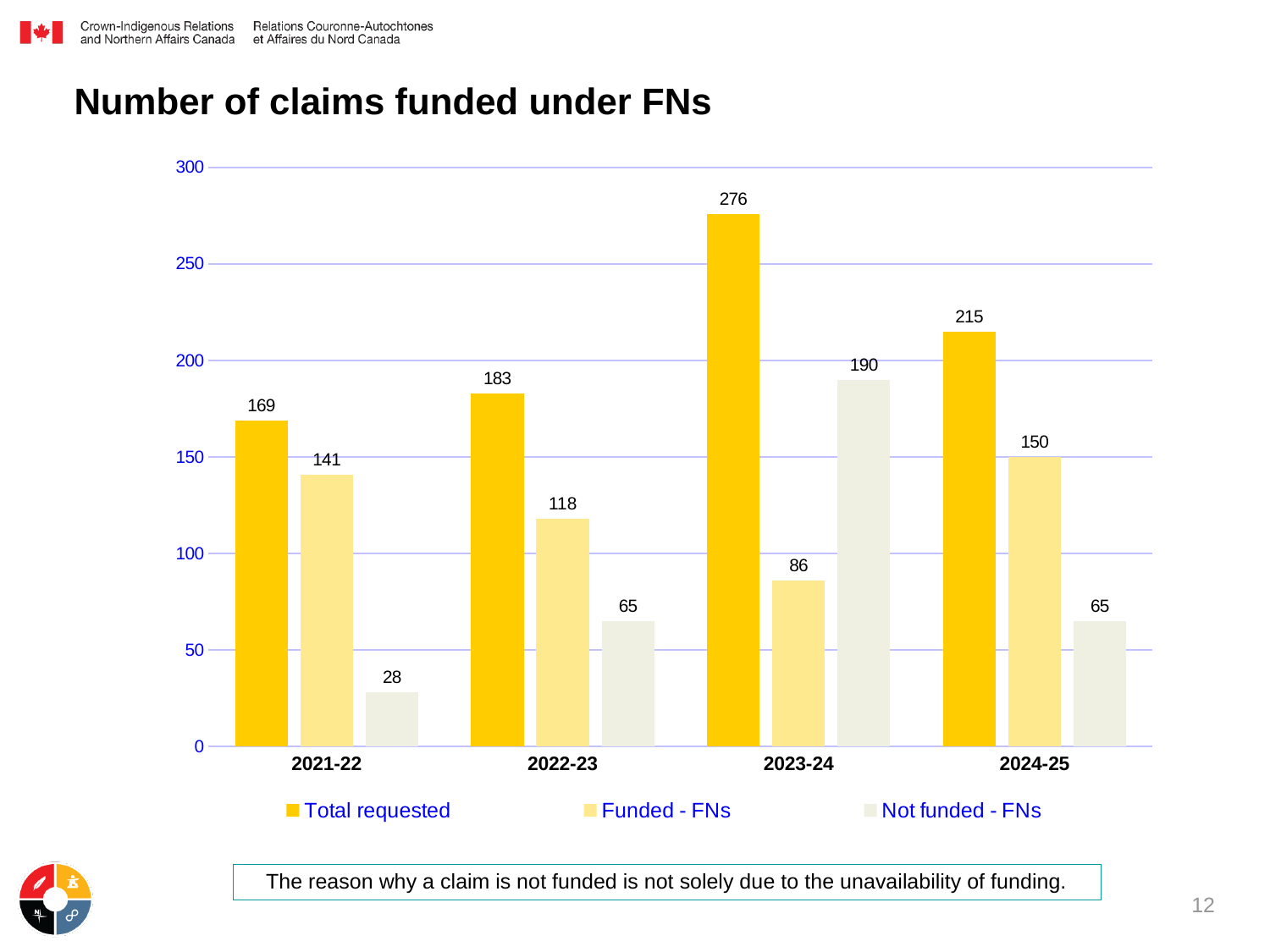
Does the Not funded - FNs value rise or fall from 2023-24 to 2024-25? Fall How many series does the legend list? 3 What is the difference between Total requested and Funded - FNs in 2024-25? 65 What kind of chart is shown on the slide? Bar chart How many claims were Funded - FNs in 2022-23? 118 What is the title of the chart? Number of claims funded under FNs Which is larger in 2023-24: Funded - FNs or Not funded - FNs? Not funded - FNs What is the Total requested value for 2023-24? 276 Which year has the lowest Funded - FNs value? 2023-24 Which year has the highest Total requested value? 2023-24 What is the Not funded - FNs value for 2021-22? 28 How many years are shown on the x axis? 4